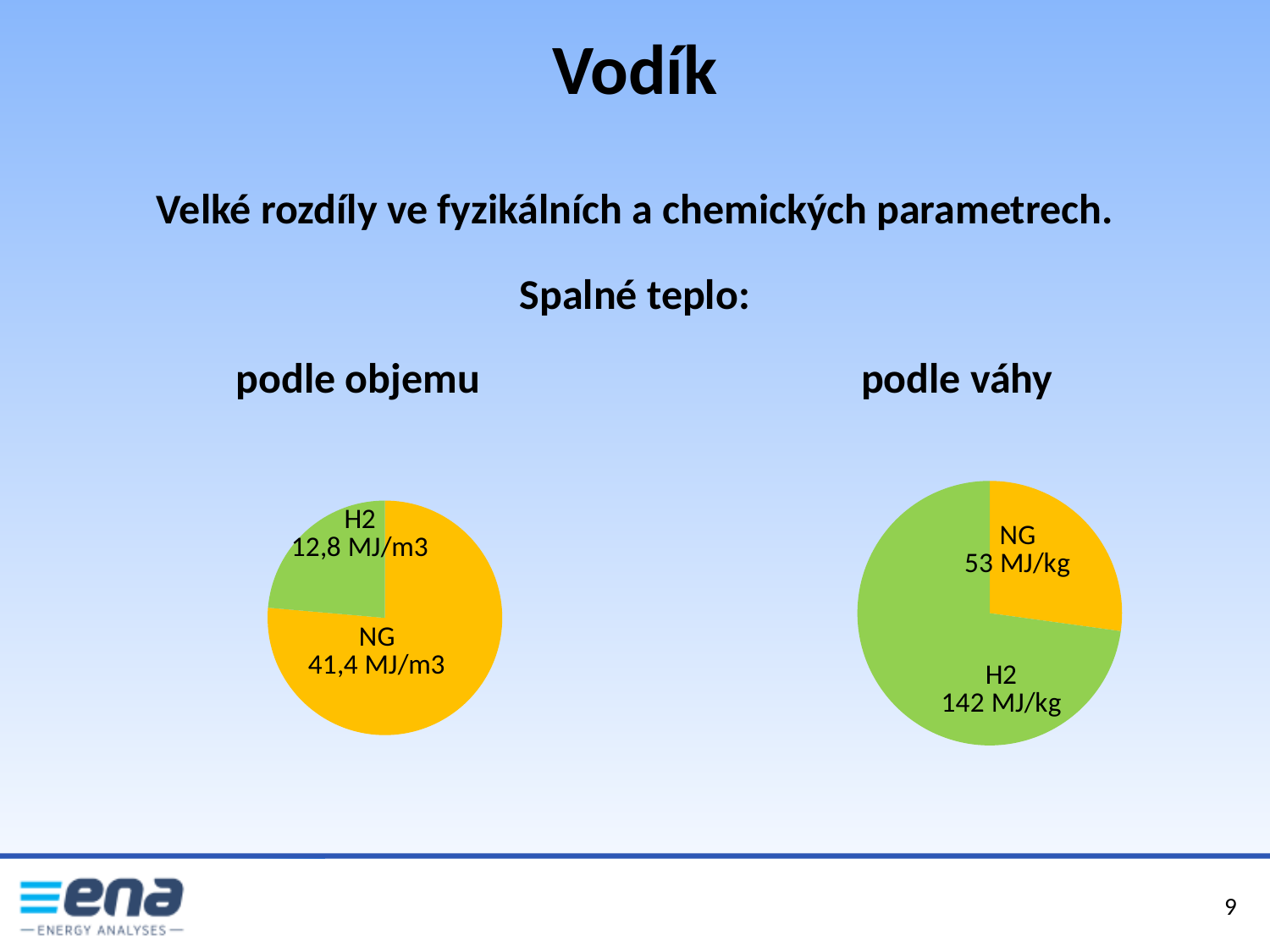
In the right pie chart (podle váhy), what is the value for H2? 142 MJ/kg In the right pie chart (podle váhy), which category has the smaller value? NG In the right pie chart (podle váhy), what is the value for NG? 53 MJ/kg In the right pie chart (podle váhy), is the value for H2 larger or smaller than the value for NG? larger How many slices does the left pie chart (podle objemu) have? 2 In the right pie chart (podle váhy), what colour is the H2 slice? green In the right pie chart (podle váhy), what is the difference between the H2 and NG values? 89 MJ/kg In the left pie chart (podle objemu), what is the difference between the NG and H2 values? 28,6 MJ/m3 In the left pie chart (podle objemu), what is the value for H2? 12,8 MJ/m3 In the left pie chart (podle objemu), what is the value for NG? 41,4 MJ/m3 What type of chart is used for 'podle váhy'? pie chart In the left pie chart (podle objemu), which category has the larger value? NG